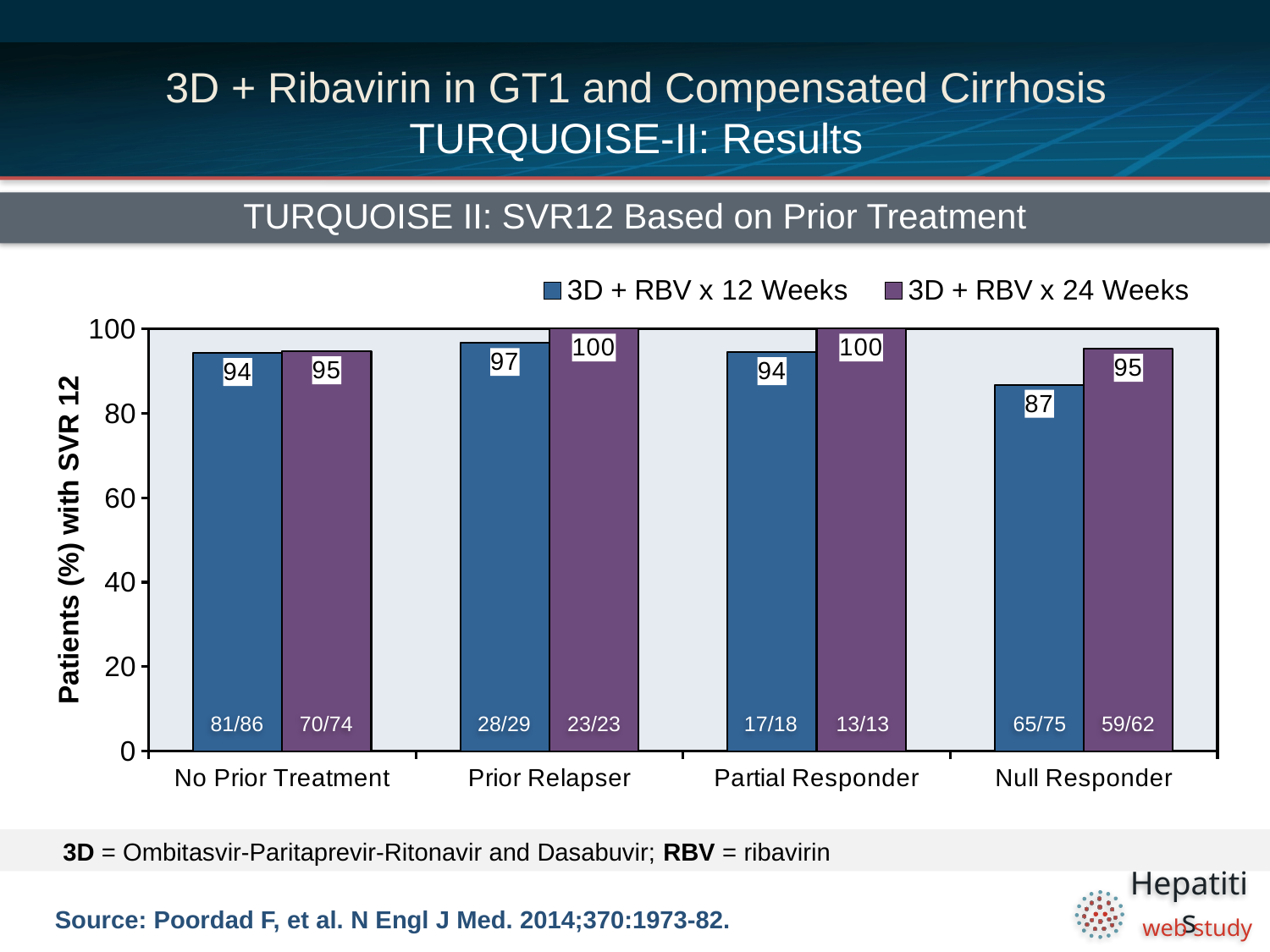
What is the fraction of patients shown for 3D + RBV x 24 Weeks in the Prior Relapser group? 23/23 What kind of chart is shown on the slide? Bar chart What is the label of the y axis? Patients (%) with SVR 12 Which prior treatment category has the lowest SVR12 rate for 3D + RBV x 12 Weeks? Null Responder What is the SVR12 rate for 3D + RBV x 12 Weeks in the Prior Relapser group? 97 What is the title of the chart? TURQUOISE II: SVR12 Based on Prior Treatment What is the difference between the 24-week and 12-week SVR12 rates in the Null Responder group? 8 What is the SVR12 rate for 3D + RBV x 24 Weeks in the Null Responder group? 95 What is the SVR12 rate for 3D + RBV x 12 Weeks in the No Prior Treatment group? 94 In the Partial Responder group, which regimen has the higher SVR12 rate, 3D + RBV x 12 Weeks or 3D + RBV x 24 Weeks? 3D + RBV x 24 Weeks How many prior treatment categories are shown on the x axis? 4 How many series does the legend list? 2